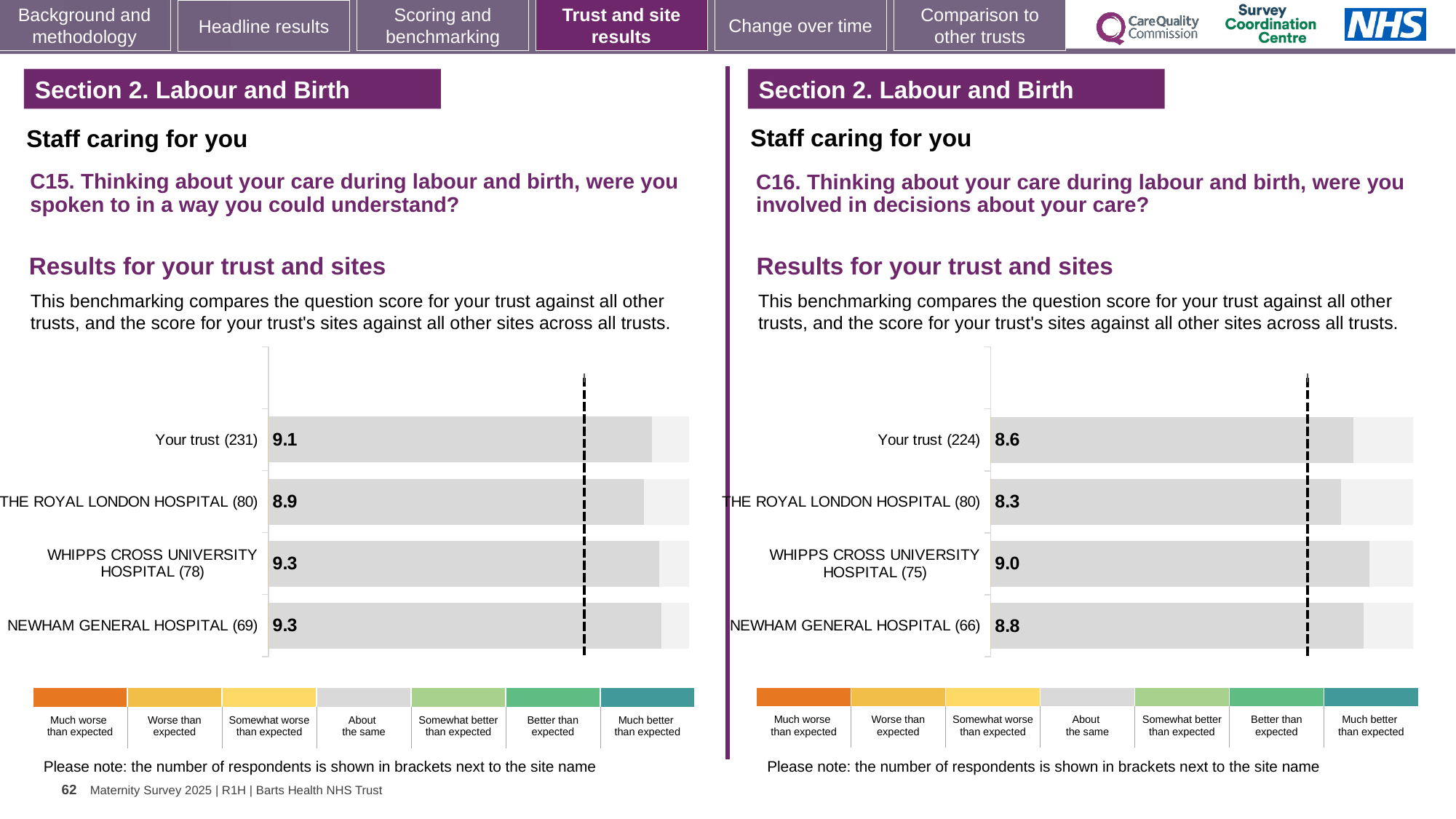
In the C15 chart on the left, what is the score for THE ROYAL LONDON HOSPITAL (80)? 8.9 In the C15 chart on the left, what is the difference between the scores for WHIPPS CROSS UNIVERSITY HOSPITAL (78) and THE ROYAL LONDON HOSPITAL (80)? 0.4 In the C16 chart on the right, what is the score for NEWHAM GENERAL HOSPITAL (66)? 8.8 In the C16 chart on the right, what is the difference between the scores for WHIPPS CROSS UNIVERSITY HOSPITAL (75) and THE ROYAL LONDON HOSPITAL (80)? 0.7 In the C15 chart on the left, what is the score for Your trust (231)? 9.1 In the C15 chart on the left, which site has the lowest score? THE ROYAL LONDON HOSPITAL (80) In the C16 chart on the right, which site has the lowest score? THE ROYAL LONDON HOSPITAL (80) In the C16 chart on the right, what is the score for Your trust (224)? 8.6 In the C16 chart on the right, which site has the highest score? WHIPPS CROSS UNIVERSITY HOSPITAL (75) In the C15 chart on the left, how many bars are plotted? 4 What type of chart is used for the C15 results on the left? Bar chart In the C16 chart on the right, which is larger: the score for Your trust (224) or for NEWHAM GENERAL HOSPITAL (66)? NEWHAM GENERAL HOSPITAL (66)